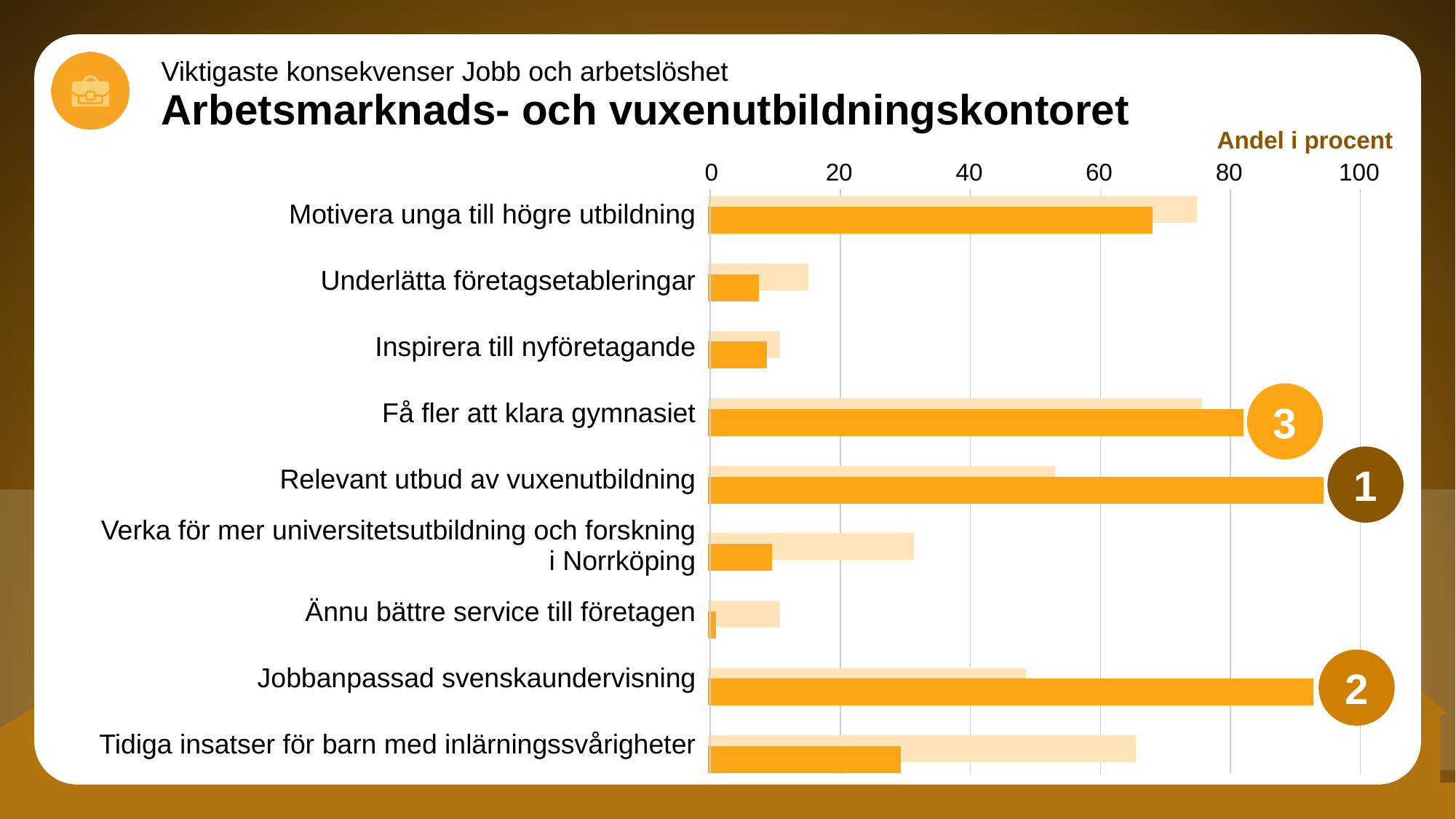
Is the dark orange bar for 'Relevant utbud av vuxenutbildning' greater or less than 80? greater Is the dark orange bar for 'Underlätta företagsetableringar' greater or less than 20? less What is the maximum value shown on the horizontal axis of the chart? 100 How many categories are listed on the vertical axis of the chart? 9 Is the light orange bar for 'Verka för mer universitetsutbildning och forskning i Norrköping' greater or less than 20? greater Which category has the shortest dark orange bar? Ännu bättre service till företagen Which has the longer dark orange bar: 'Motivera unga till högre utbildning' or 'Tidiga insatser för barn med inlärningssvårigheter'? Motivera unga till högre utbildning What kind of chart is shown on the slide? bar chart What unit label is shown above the chart's horizontal axis? Andel i procent Which has the longer light orange bar: 'Tidiga insatser för barn med inlärningssvårigheter' or 'Inspirera till nyföretagande'? Tidiga insatser för barn med inlärningssvårigheter